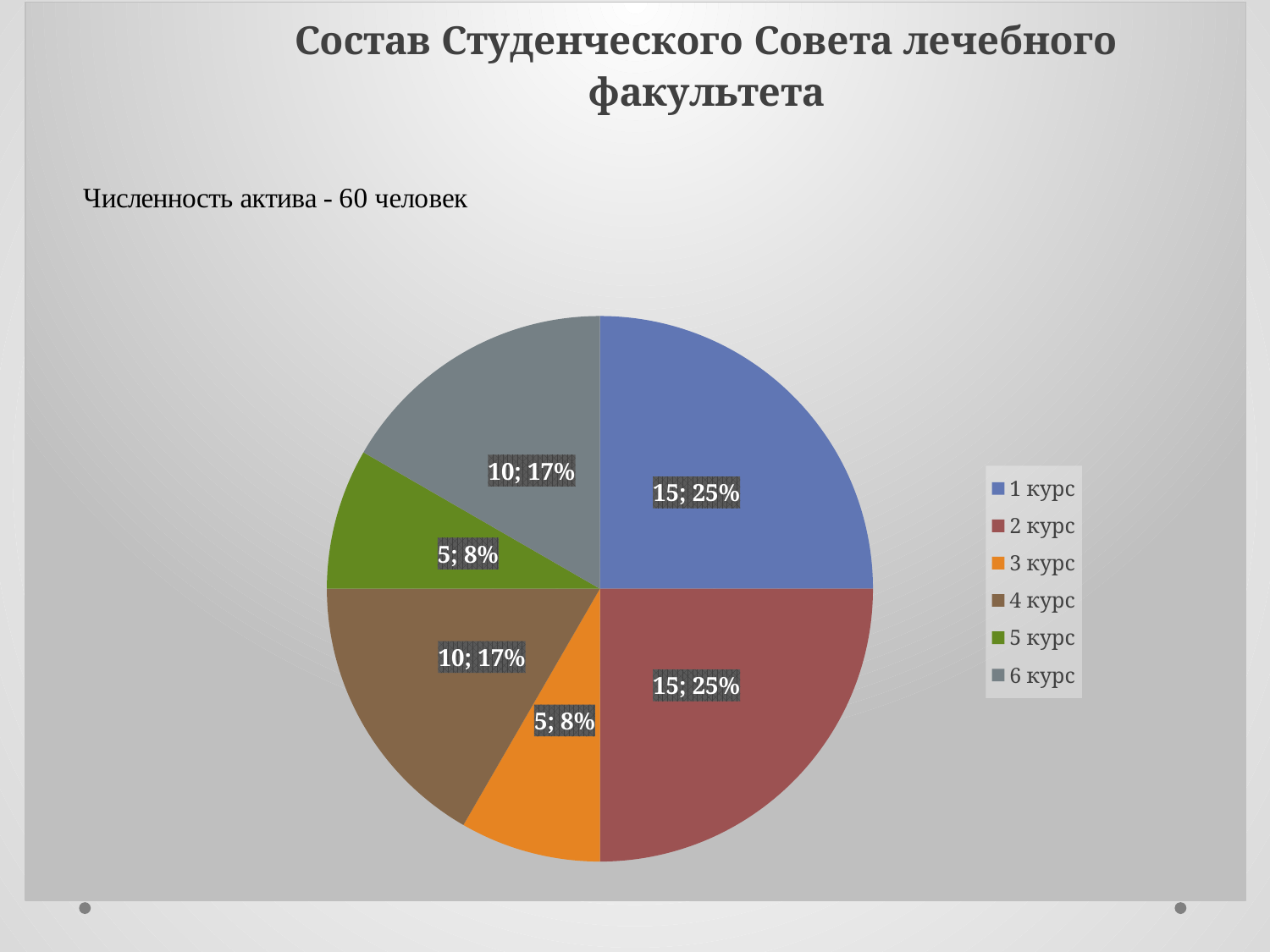
What is the total of all slices in the pie chart? 60 What is the difference between the values for 1 курс and 5 курс? 10 How many entries does the legend list? 6 What is the value for 4 курс? 10 What type of chart is shown on the slide? pie chart Which is larger, the value for 4 курс or the value for 3 курс? 4 курс What share of the pie does 2 курс represent? 25% What share of the pie does 6 курс represent? 17% How many slices does the pie chart have? 6 What is the value for 1 курс? 15 What is the value for 3 курс? 5 What is the title of the chart? Состав Студенческого Совета лечебного факультета